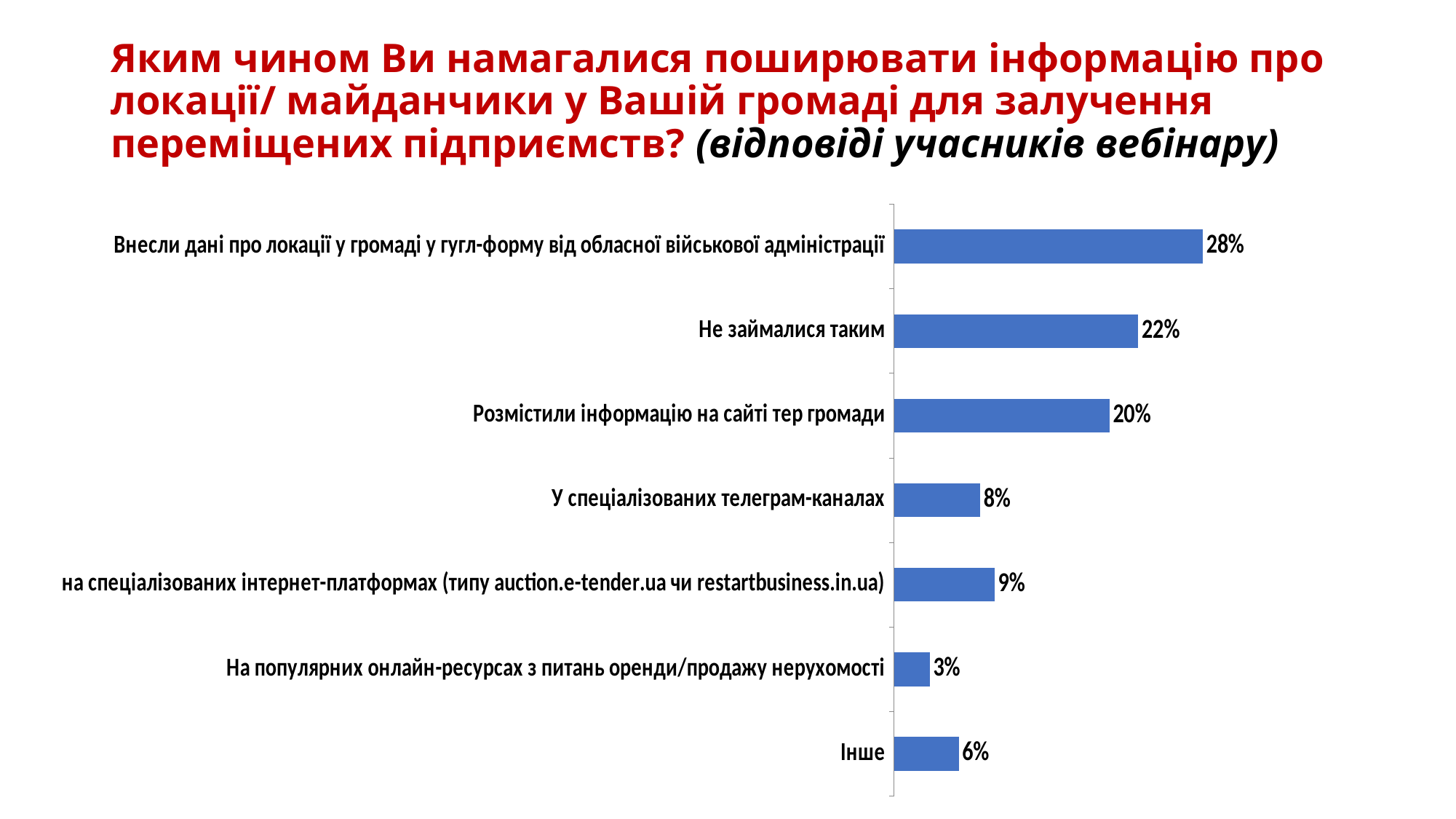
What is the value for "У спеціалізованих телеграм-каналах"? 8% What is the difference in percentage points between the highest and lowest values in the chart? 25 Which category has the lowest value in the chart? На популярних онлайн-ресурсах з питань оренди/продажу нерухомості How many categories are shown in the chart? 7 What percentage is shown for "Розмістили інформацію на сайті тер громади"? 20% Which category has the highest value in the chart? Внесли дані про локації у громаді у гугл-форму від обласної військової адміністрації What is the value shown for "Не займалися таким"? 22% What type of chart is shown on the slide? Bar chart What percentage of respondents entered data about locations into the Google form from the regional military administration ("Внесли дані про локації у громаді у гугл-форму від обласної військової адміністрації")? 28% What percentage is shown for "Інше"? 6% What is the difference in percentage points between "Не займалися таким" and "Розмістили інформацію на сайті тер громади"? 2 Which is larger: the value for "У спеціалізованих телеграм-каналах" or the value for "на спеціалізованих інтернет-платформах"? на спеціалізованих інтернет-платформах